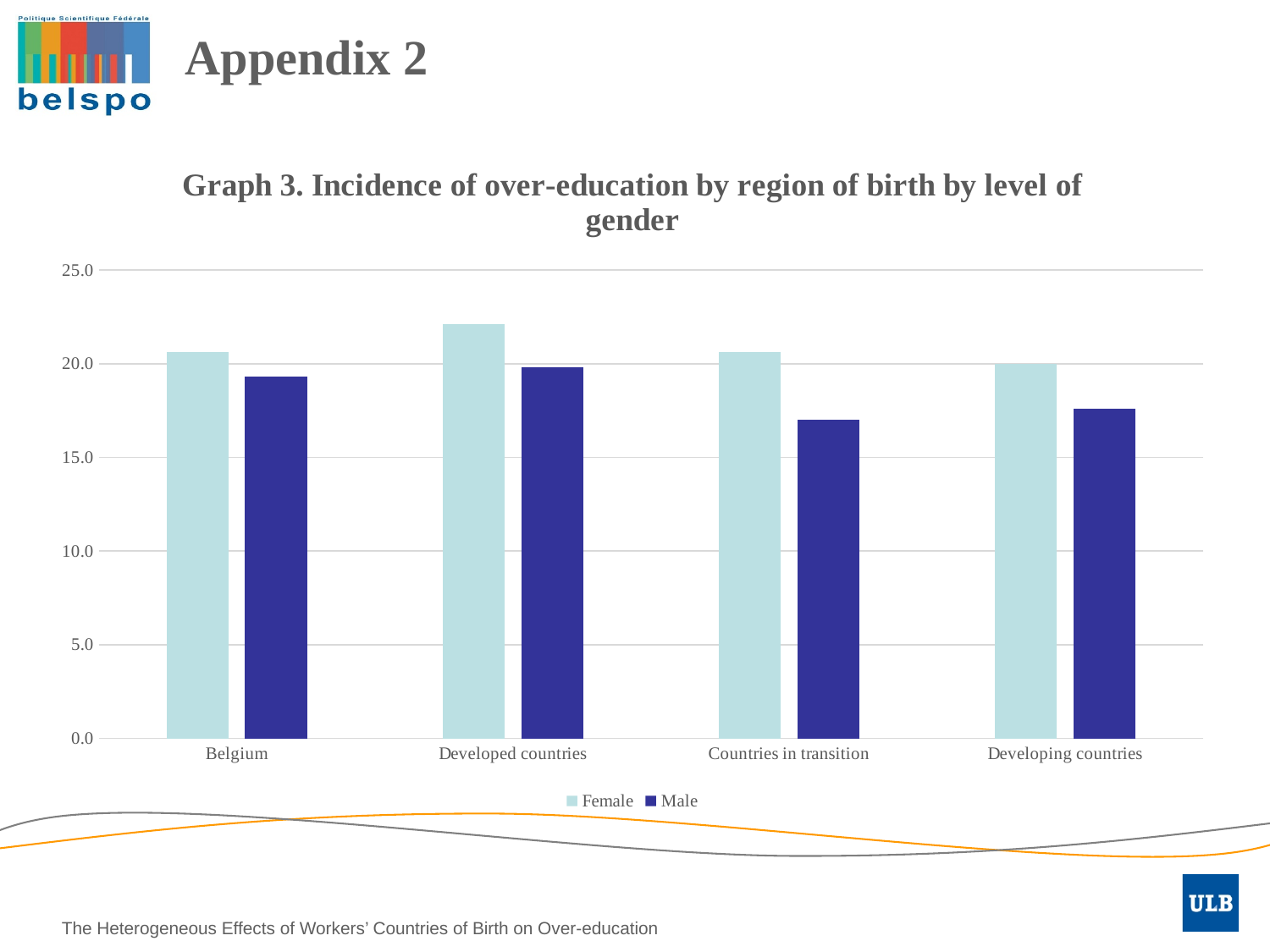
Is the Male value for Countries in transition greater or less than 20.0? less For Countries in transition, which is larger, the Female value or the Male value? Female Is the Female value for Developed countries greater or less than 20.0? greater How many series does the legend list? 2 How many regions of birth are shown on the x axis? 4 Which region of birth has the lowest Male value? Countries in transition Which region of birth has the highest Female value? Developed countries Which series is shown in dark blue in the legend? Male For Belgium, which is larger, the Female value or the Male value? Female What kind of chart is shown on the slide? bar chart Is the Male value for Belgium greater or less than 15.0? greater